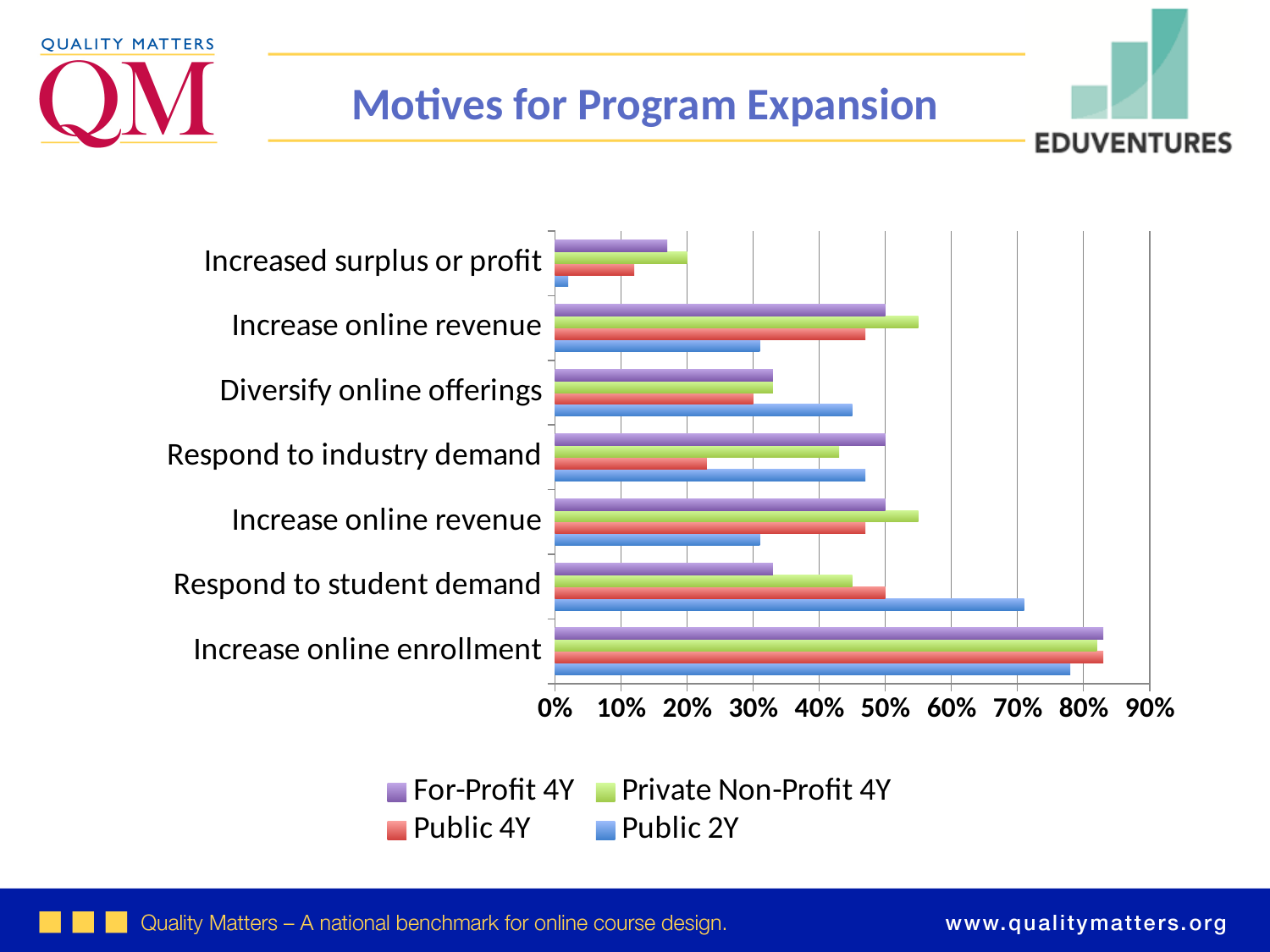
Which series has the lowest value for Respond to industry demand? Public 4Y Is the Public 2Y value for Increased surplus or profit greater or less than 10%? less How many categories are plotted on the y axis? 7 Which category has the highest Public 2Y value? Increase online enrollment For Respond to student demand, which is larger: the Public 2Y value or the For-Profit 4Y value? Public 2Y Is the Public 2Y value for Diversify online offerings greater or less than 40%? greater Is the Public 4Y value for Respond to industry demand greater or less than 30%? less What is the title of the chart? Motives for Program Expansion What kind of chart is shown on the slide? Bar chart How many series does the legend list? 4